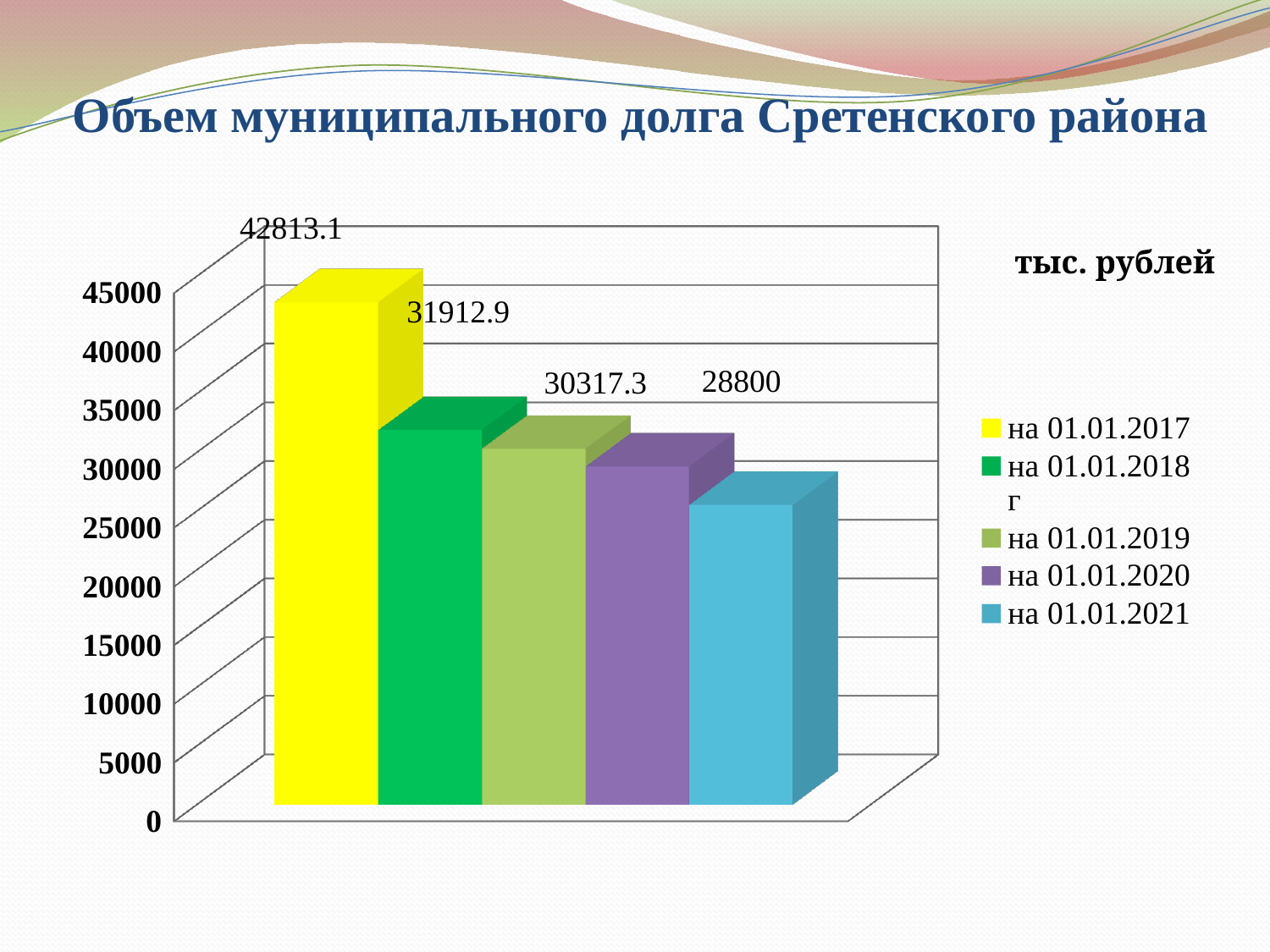
What is the value for на 01.01.2018? 31912.9 What type of chart is shown on the slide? bar chart What is the value for на 01.01.2019? 30317.3 Which date has the highest municipal debt? на 01.01.2017 How many bars are plotted on the chart? 5 Which date has the lowest municipal debt? на 01.01.2021 How many entries does the legend list? 5 What unit is indicated for the values on the chart? тыс. рублей What is the title of the chart? Объем муниципального долга Сретенского района What is the value for на 01.01.2017? 42813.1 Do the values rise or fall from на 01.01.2017 to на 01.01.2021? fall What is the difference between the values for на 01.01.2017 and на 01.01.2018? 10900.2